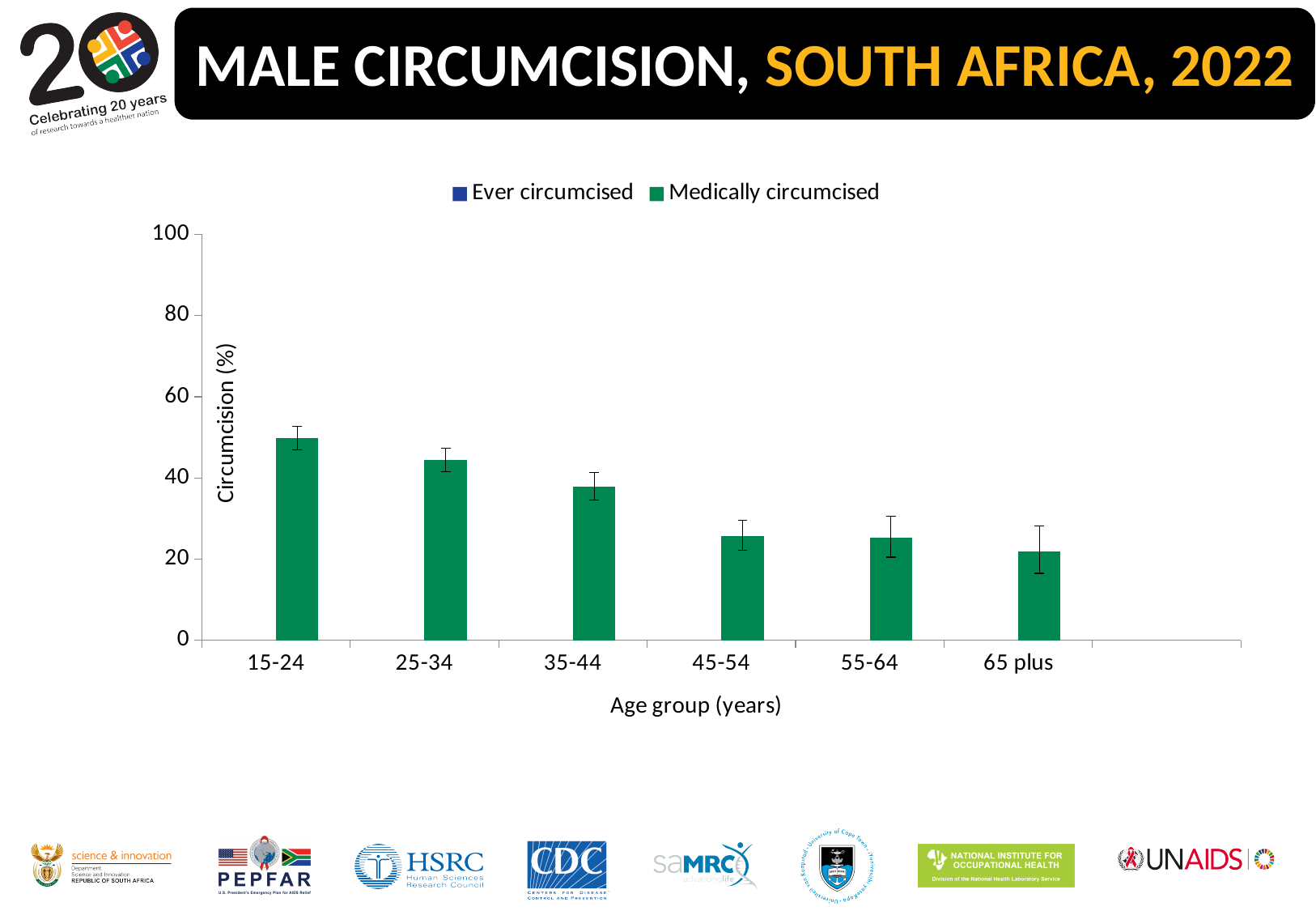
How many age groups are shown on the x axis? 6 Do the circumcision percentages rise or fall as age group increases along the x axis? fall Which age group has the lowest circumcision percentage? 65 plus Is the value for the 35-44 age group greater or less than 20? greater Is the value for the 65 plus age group greater or less than 40? less Is the value for the 45-54 age group greater or less than 40? less What is the label of the y axis? Circumcision (%) How many series does the legend list? 2 Which age group has the highest circumcision percentage? 15-24 Which has a higher circumcision percentage, the 15-24 age group or the 45-54 age group? 15-24 What kind of chart is shown on the slide? bar chart